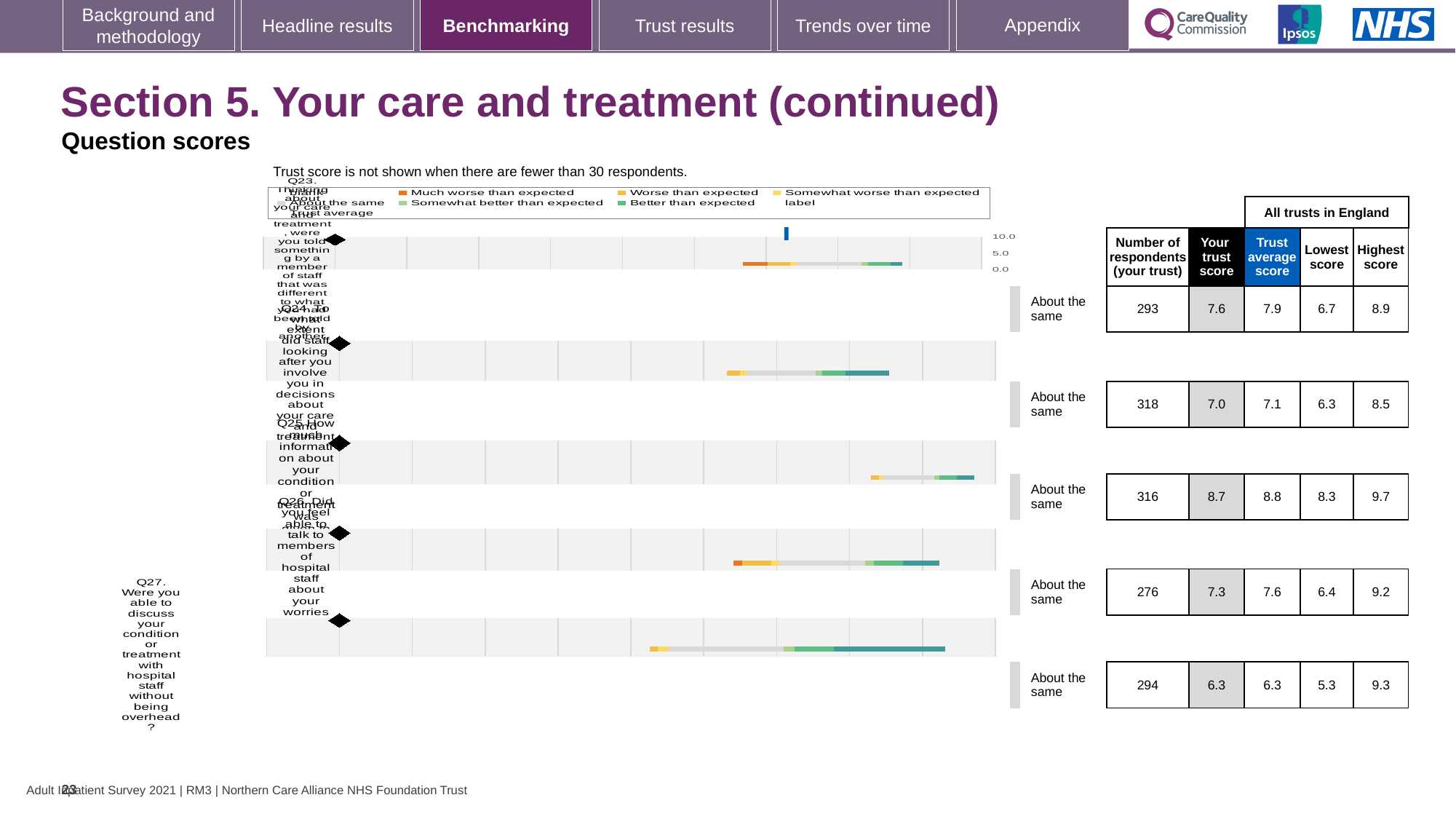
In the table beside the chart, what is the 'Trust average score' for Q26? 7.6 In the table beside the chart, what is the 'Lowest score' for Q27? 5.3 For Q26, which is larger in the table beside the chart: 'Your trust score' or 'Trust average score'? Trust average score What kind of chart is used to show the question scores on this slide? bar chart How many questions (Q23 to Q27) are plotted in the benchmarking chart? 5 Which question has the lowest 'Your trust score' in the table beside the chart? Q27 What colour does the legend use for 'Much worse than expected'? orange In the table beside the chart, what is the difference between the 'Highest score' and 'Lowest score' for Q23? 2.2 Which question has the highest 'Your trust score' in the table beside the chart? Q25 What is the highest value shown on the chart's score axis? 10.0 In the table beside the chart, what is the 'Your trust score' for Q23? 7.6 In the table beside the chart, how many respondents are listed for Q24? 318